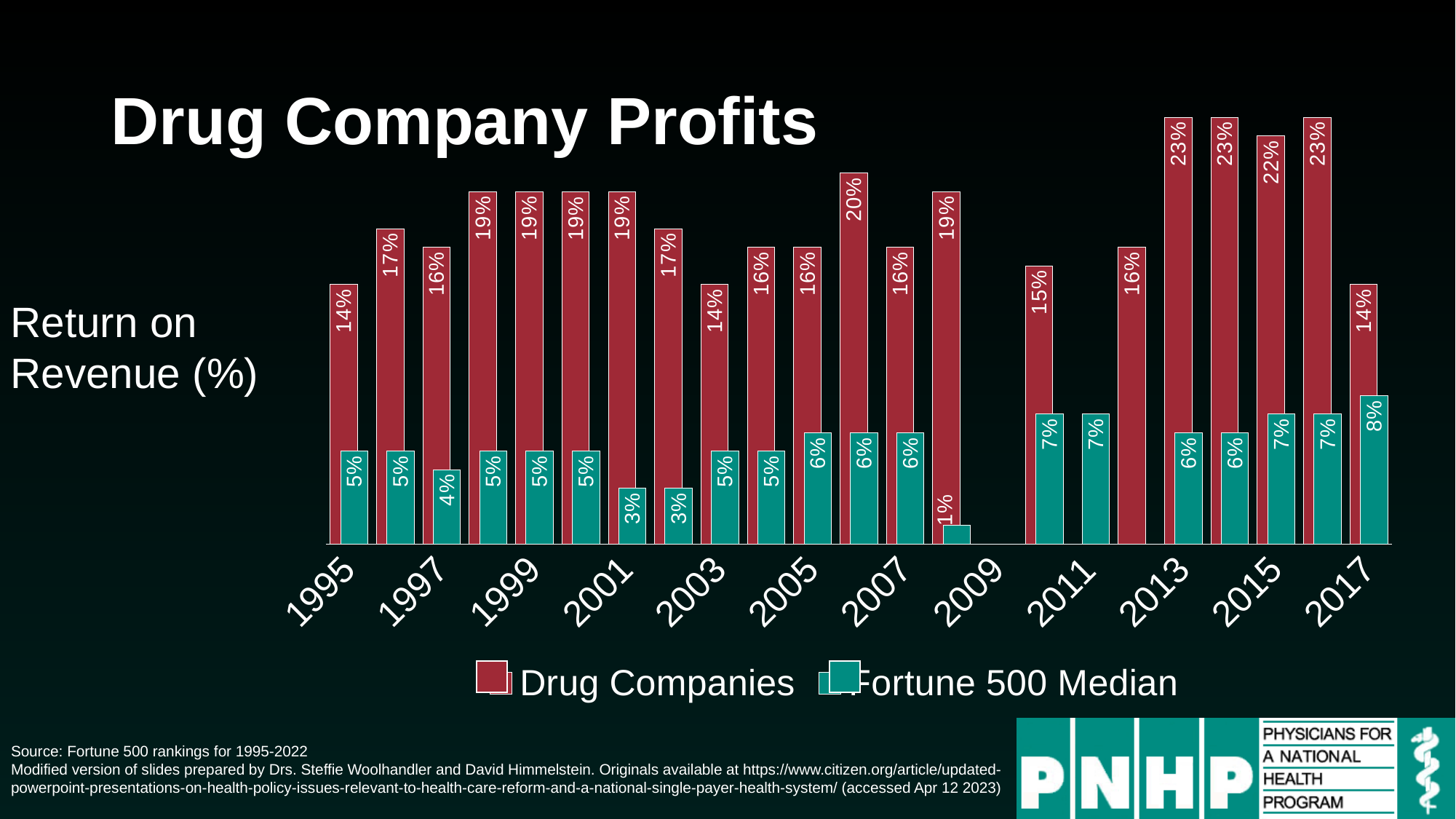
What is the return on revenue for Drug Companies in 2015? 22% What type of chart is shown on the slide? Bar chart What is the title of the chart? Drug Company Profits What is the highest return on revenue shown for Drug Companies? 23% How many series does the legend list? 2 What is the difference between the Drug Companies and Fortune 500 Median values in 2017? 6 percentage points What is the lowest Fortune 500 Median value shown on the chart? 1% Which is larger: the Drug Companies value in 2013 or in 2015? 2013 What is the return on revenue for Drug Companies in 1995? 14% What is the Fortune 500 Median return on revenue in 2017? 8% In which year is the Fortune 500 Median return on revenue highest? 2017 What is the Fortune 500 Median return on revenue in 1997? 4%